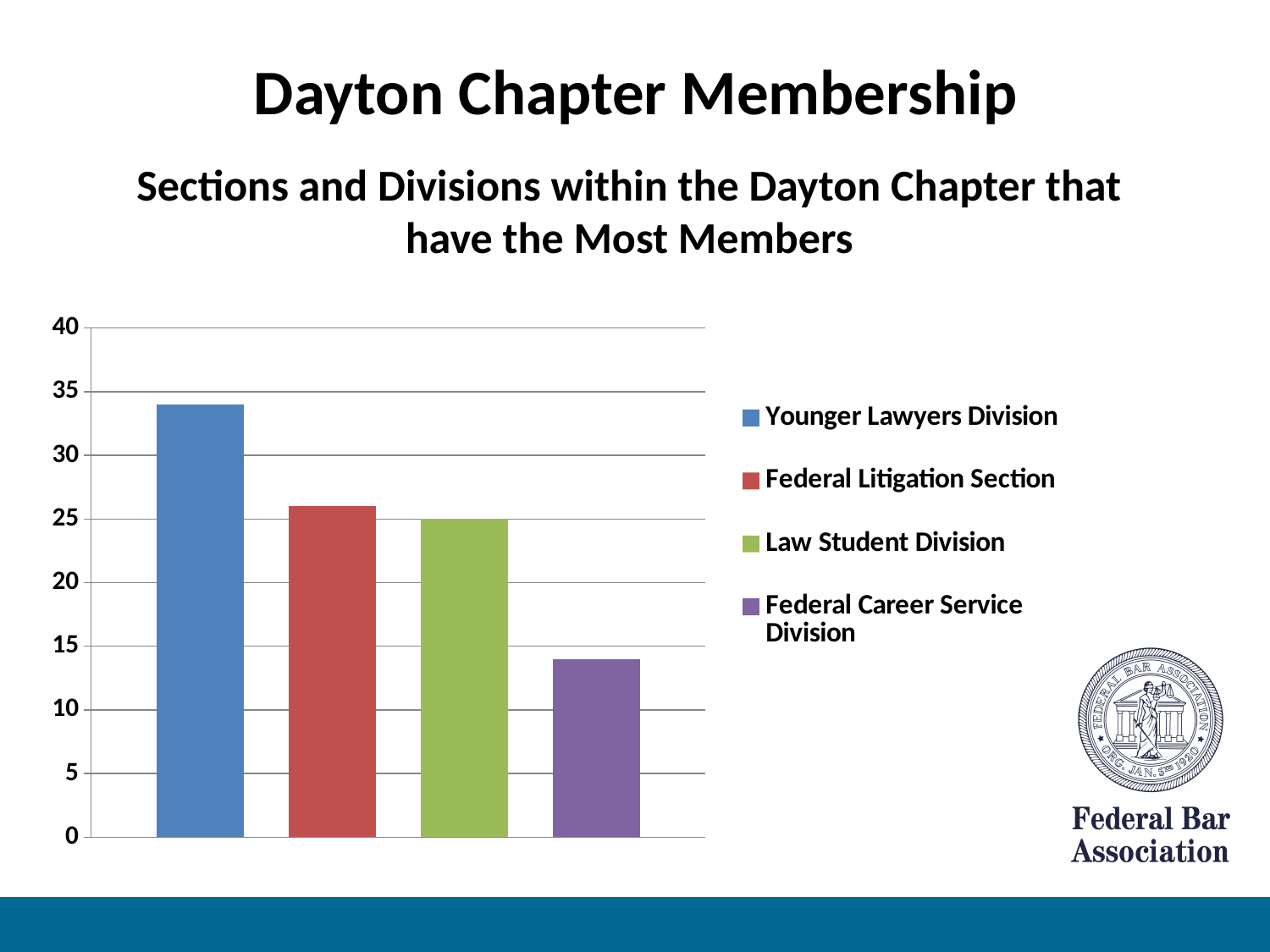
How many bars are plotted in the chart? 4 Which has more members, the Younger Lawyers Division or the Federal Career Service Division? Younger Lawyers Division Which has more members, the Federal Litigation Section or the Federal Career Service Division? Federal Litigation Section Which section or division has the lowest number of members? Federal Career Service Division What is the title of the chart? Sections and Divisions within the Dayton Chapter that have the Most Members How many series does the legend list? 4 Is the value for the Federal Litigation Section greater or less than 20? greater Is the value for the Younger Lawyers Division greater or less than 30? greater Which section or division has the highest number of members? Younger Lawyers Division What is the value for the Law Student Division? 25 What kind of chart is shown on the slide? bar chart Is the value for the Federal Career Service Division greater or less than 15? less